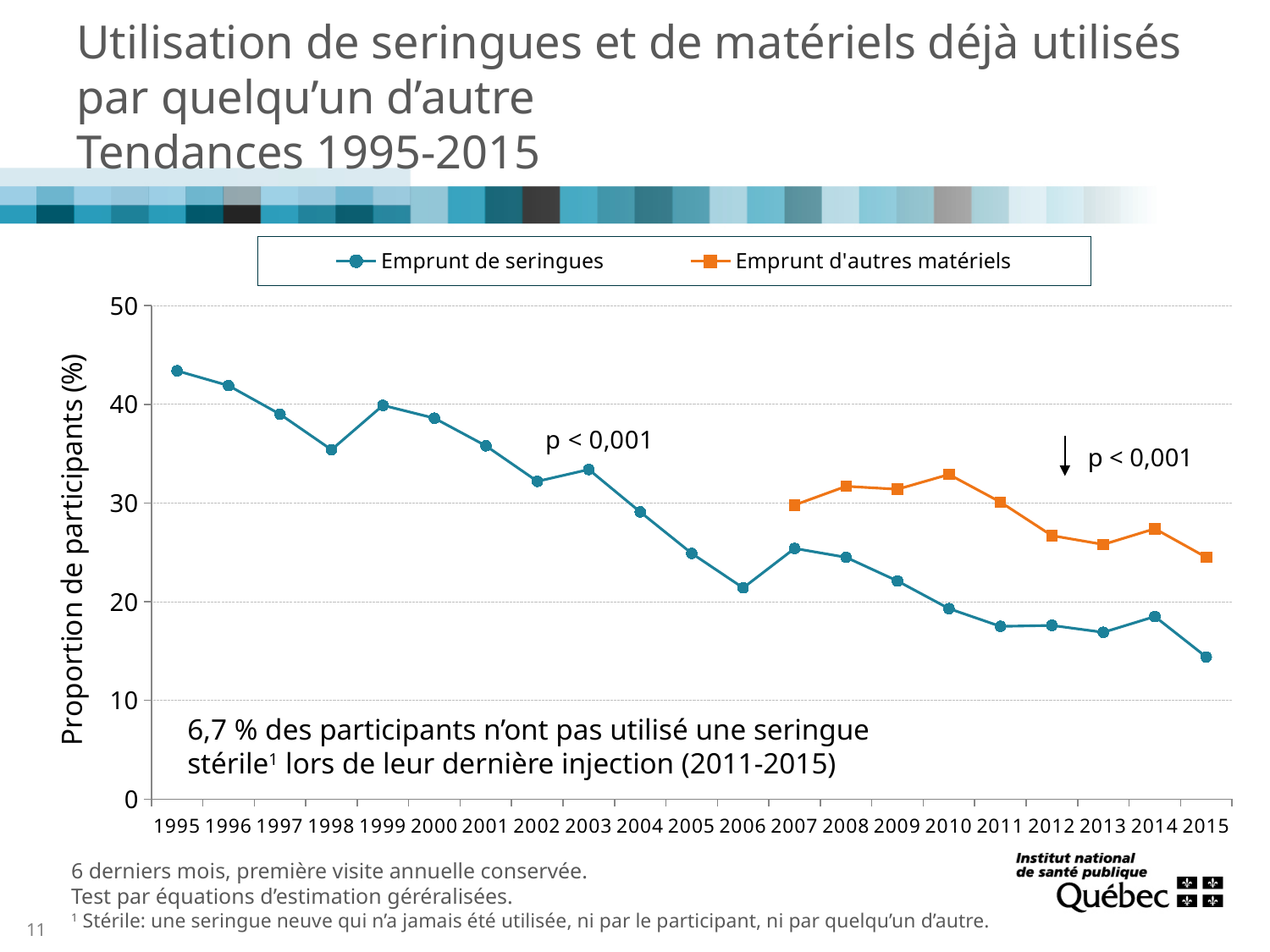
In which year is the value for Emprunt d'autres matériels highest? 2010 In which year is the value for Emprunt d'autres matériels lowest? 2015 How many series does the legend list? 2 Does the Emprunt de seringues series generally rise or fall from 1995 to 2015? fall Is the value for Emprunt de seringues in 2015 greater or less than 20? less In 2010, which series has the larger value, Emprunt de seringues or Emprunt d'autres matériels? Emprunt d'autres matériels Is the value for Emprunt de seringues in 1995 greater or less than 40? greater How many years are shown along the x axis? 21 What kind of chart is shown on the slide? line chart In which year is the value for Emprunt de seringues highest? 1995 Is the value for Emprunt d'autres matériels in 2010 greater or less than 30? greater In which year is the value for Emprunt de seringues lowest? 2015